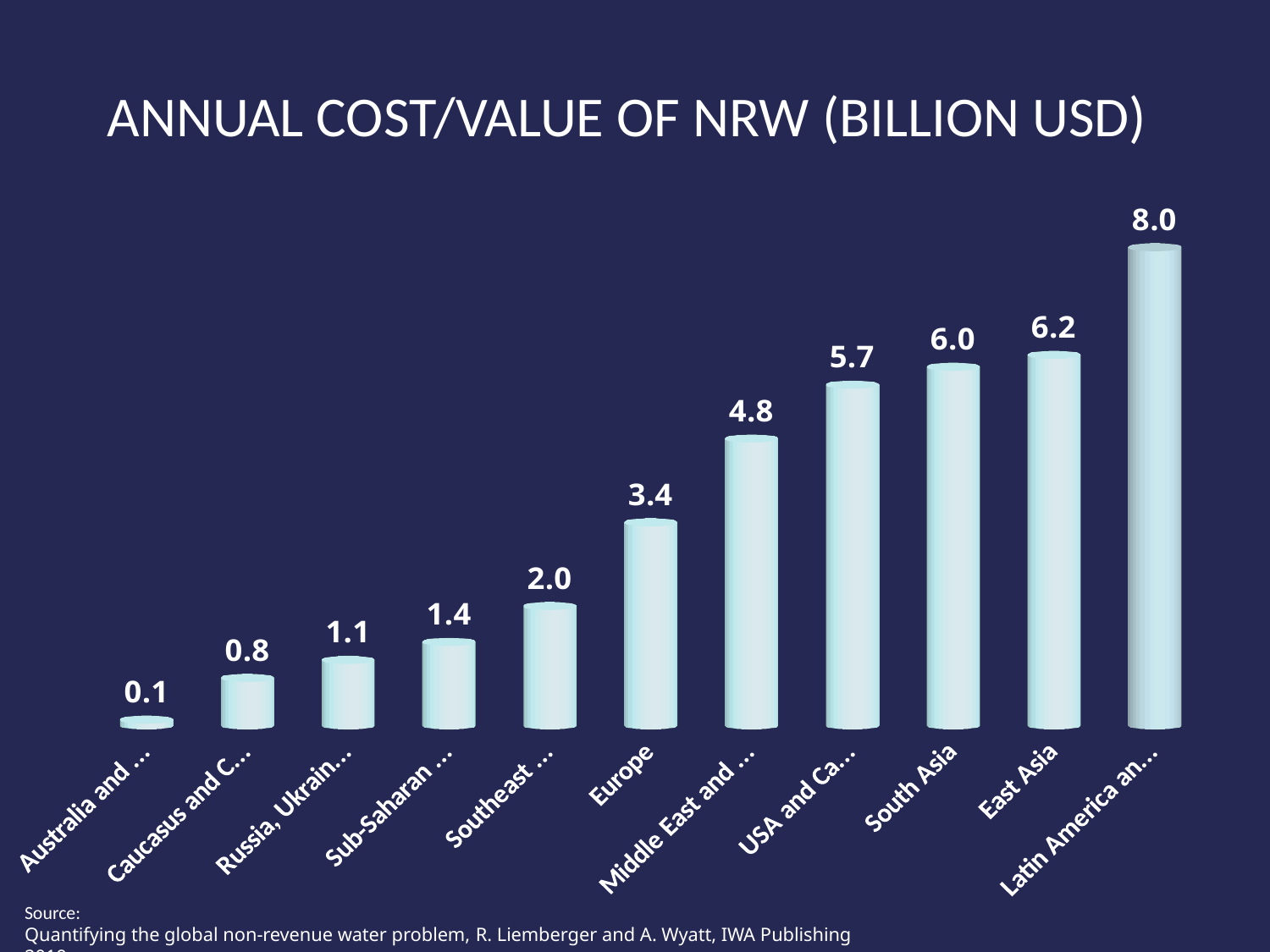
What kind of chart is shown on the slide? Bar chart Which has a larger value, Europe or South Asia? South Asia What is the highest value shown on the chart? 8.0 What is the difference between the values for East Asia and South Asia? 0.2 What is the value for South Asia? 6.0 What is the value for Europe? 3.4 Do the values rise or fall from left to right along the x axis? Rise What is the value for East Asia? 6.2 What is the lowest value shown on the chart? 0.1 How many categories are shown on the chart? 11 What is the title of the chart? ANNUAL COST/VALUE OF NRW (BILLION USD) What is the difference between the values for East Asia and Europe? 2.8